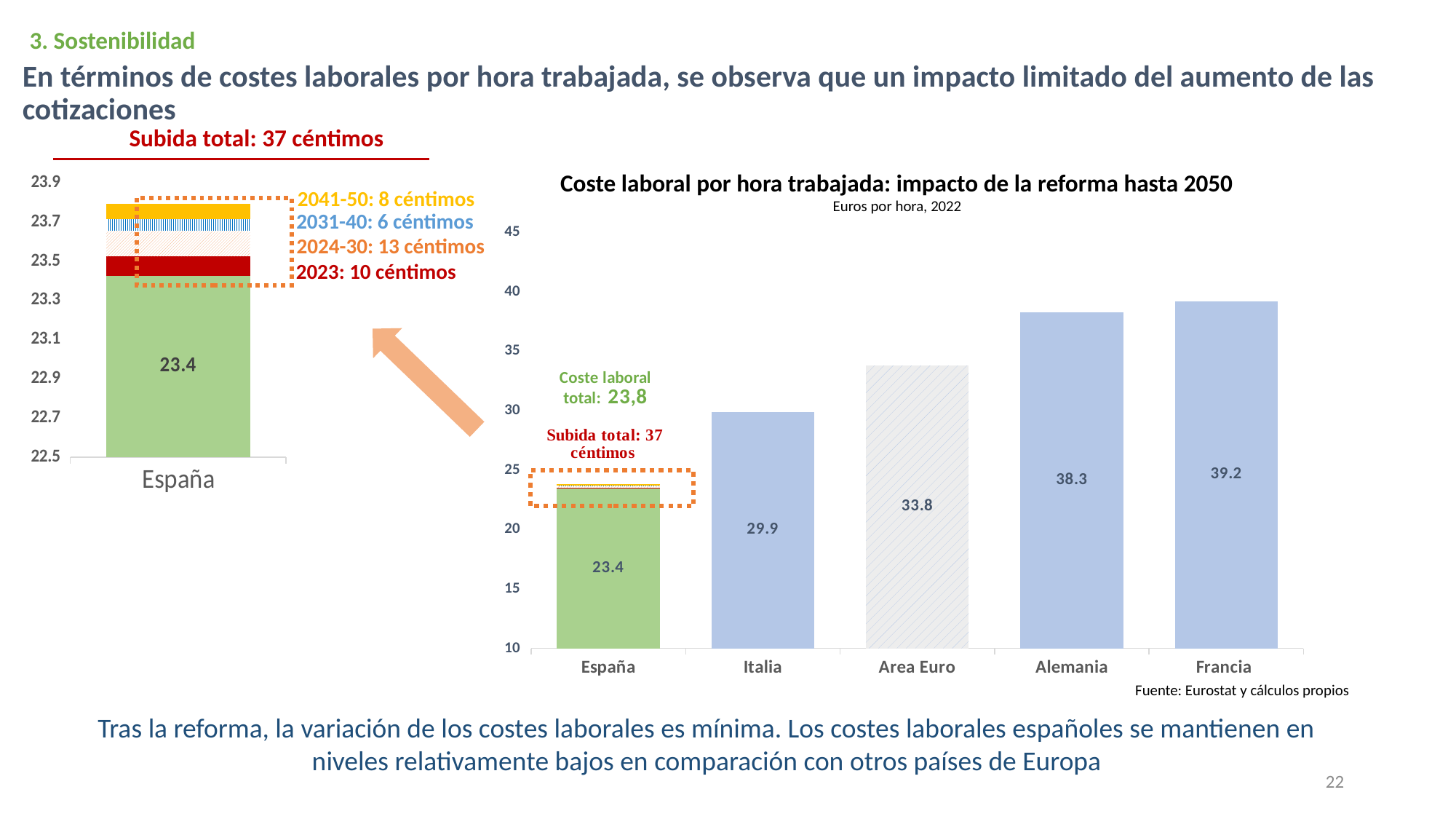
In the chart on the left of the slide, what is the value of the green base segment for España? 23.4 In the chart titled 'Coste laboral por hora trabajada: impacto de la reforma hasta 2050', which country has the highest labour cost per hour? Francia In the chart titled 'Coste laboral por hora trabajada: impacto de la reforma hasta 2050', what is the value for Area Euro? 33.8 In the chart titled 'Coste laboral por hora trabajada: impacto de la reforma hasta 2050', what unit is stated in the subtitle? Euros por hora, 2022 In the chart titled 'Coste laboral por hora trabajada: impacto de la reforma hasta 2050', what is the difference between the values for Alemania and España? 14.9 In the chart titled 'Coste laboral por hora trabajada: impacto de la reforma hasta 2050', which is larger, the value for Italia or the value for Area Euro? Area Euro In the chart titled 'Coste laboral por hora trabajada: impacto de la reforma hasta 2050', which category has the lowest value? España In the chart titled 'Coste laboral por hora trabajada: impacto de la reforma hasta 2050', how many categories are shown on the x axis? 5 In the chart titled 'Coste laboral por hora trabajada: impacto de la reforma hasta 2050', what is the value for Francia? 39.2 What kind of chart is the one on the right of the slide? Bar chart In the chart titled 'Coste laboral por hora trabajada: impacto de la reforma hasta 2050', what is the value for Italia? 29.9 In the chart on the left of the slide, what is the total increase ('Subida total') shown above the chart? 37 céntimos